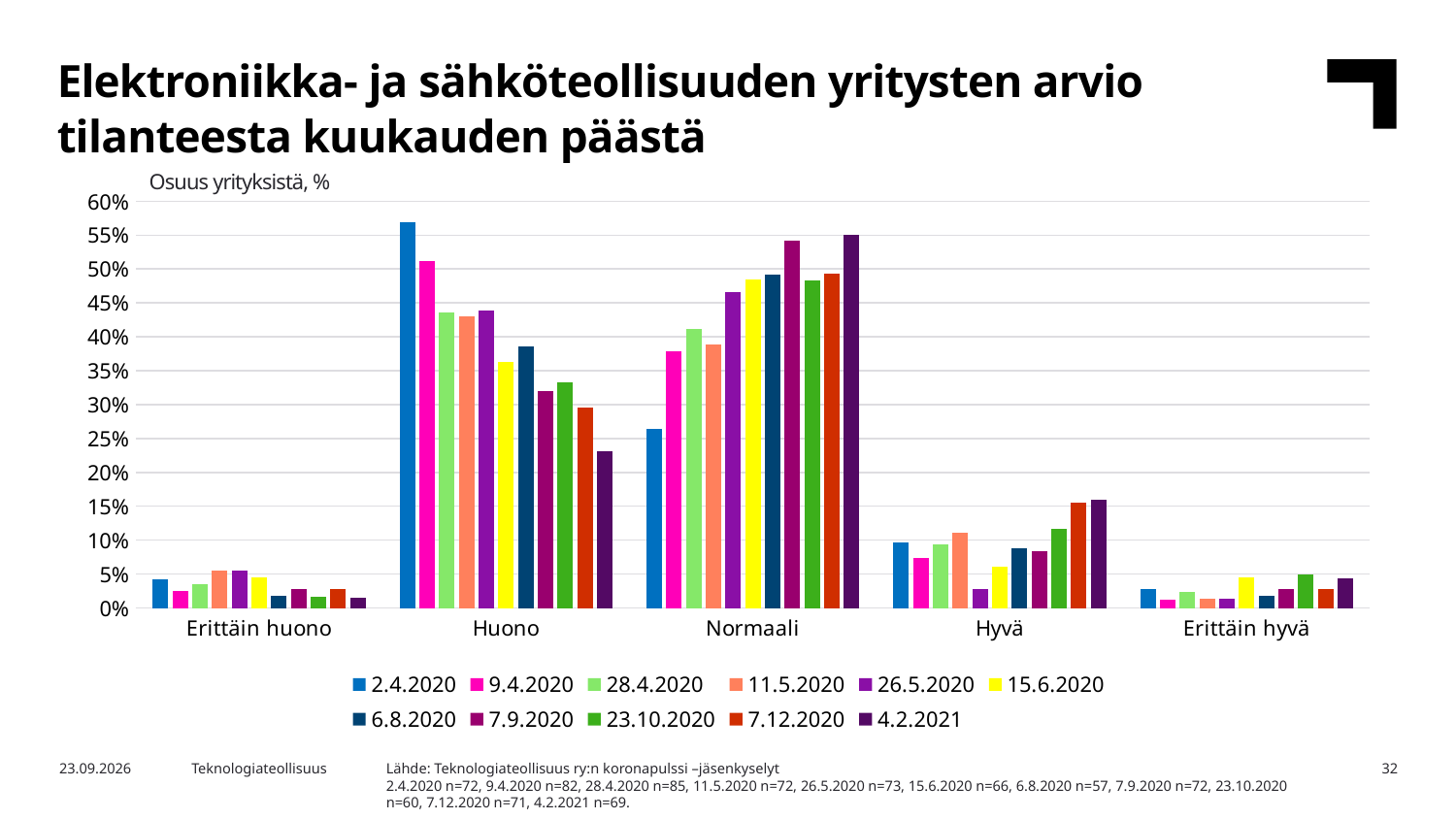
Is the value for 4.2.2021 in the Huono category greater or less than 30%? less How many categories are shown on the x axis of the chart? 5 How many series does the chart legend list? 11 Is the value for 2.4.2020 in the Normaali category greater or less than 30%? less For the 2.4.2020 series, which is larger: the value for Huono or the value for Normaali? Huono Is the value for 4.2.2021 in the Normaali category greater or less than 50%? greater In the Hyvä category, which series has the lowest value? 26.5.2020 What kind of chart is shown on the slide? bar chart In the Huono category, which series has the highest value? 2.4.2020 In the Normaali category, which series has the lowest value? 2.4.2020 What is the label shown above the y axis of the chart? Osuus yrityksistä, %